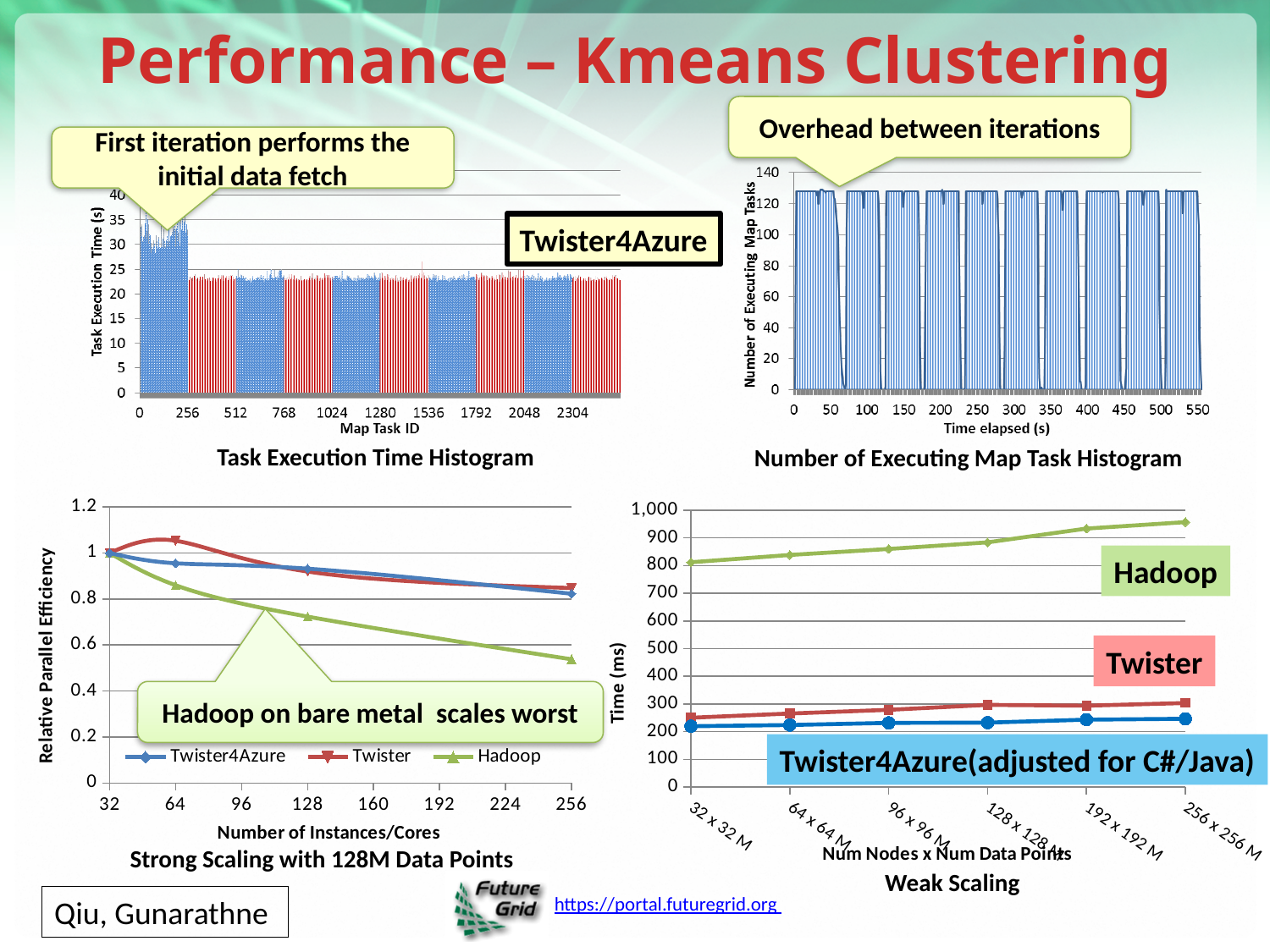
In the Number of Executing Map Task Histogram, is the plateau value of executing map tasks greater or less than 140? less What kind of chart is the Task Execution Time Histogram? bar chart In the Strong Scaling with 128M Data Points chart, does the Hadoop series rise or fall as the number of instances/cores increases? fall In the Weak Scaling chart, is the Hadoop value at 256 x 256 M greater or less than 900? greater In the Strong Scaling with 128M Data Points chart, how many series does the legend list? 3 In the Weak Scaling chart, does the Hadoop series rise or fall from 32 x 32 M to 256 x 256 M? rise In the Strong Scaling with 128M Data Points chart, is the Hadoop value at 256 instances/cores greater or less than 0.6? less In the Weak Scaling chart, how many Num Nodes x Num Data Points categories are shown on the x axis? 6 In the Weak Scaling chart, which series has the highest time across all categories? Hadoop In the Strong Scaling with 128M Data Points chart, which series has the lowest relative parallel efficiency at 256 instances/cores? Hadoop In the Weak Scaling chart, which is larger at 32 x 32 M: Twister or Twister4Azure? Twister In the Strong Scaling with 128M Data Points chart, what is the relative parallel efficiency of all three series at 32 instances/cores? 1